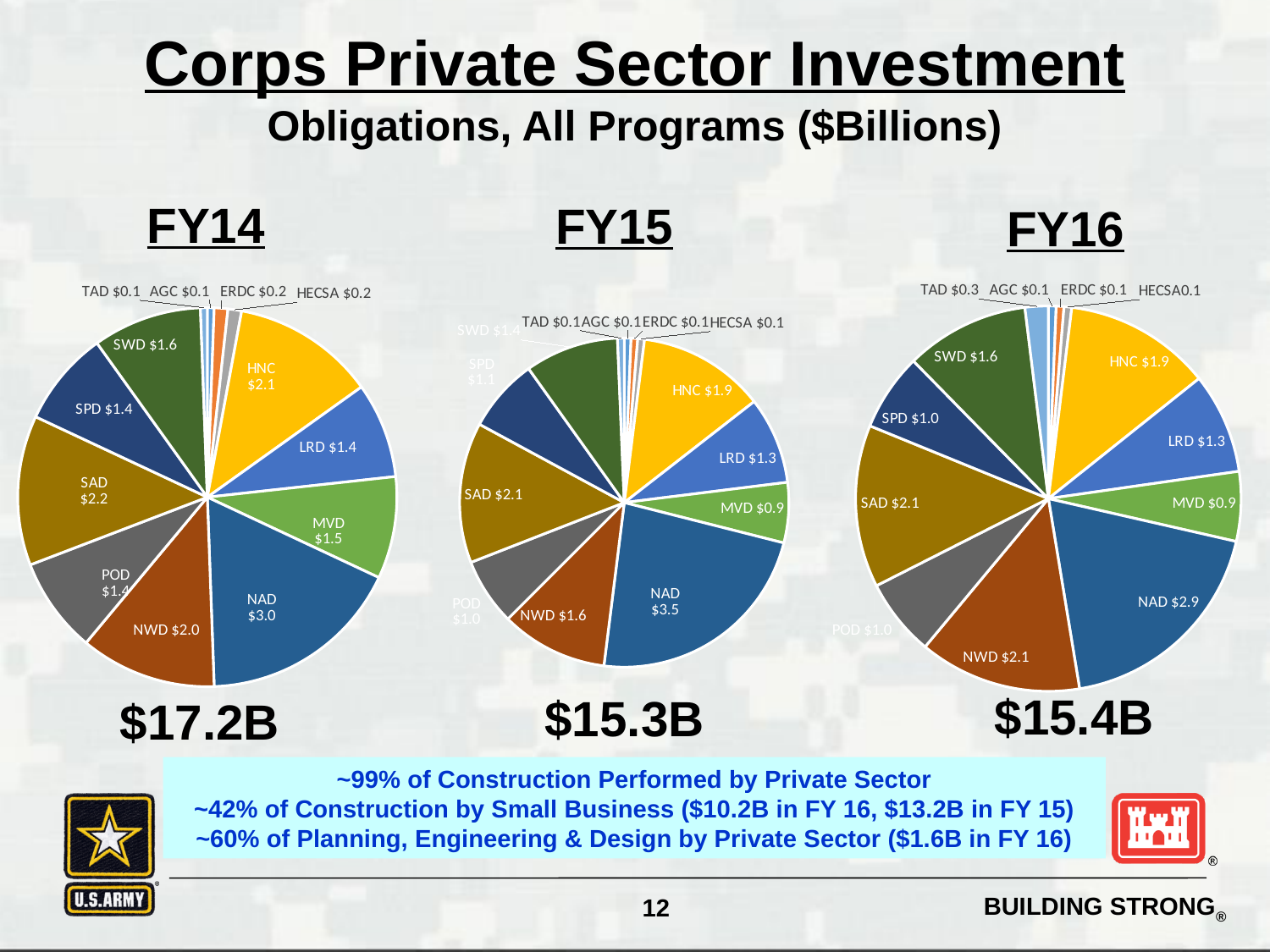
What type of chart is used for FY14, FY15 and FY16? Pie chart In the FY15 pie chart, what is the value for HNC? $1.9 In the FY14 pie chart, which category has the largest slice? NAD In the FY14 pie chart, what is the difference between the NAD value and the HNC value? $0.9 What is the difference between the NAD value in the FY15 pie chart and the NAD value in the FY16 pie chart? $0.6 In the FY16 pie chart, which is larger, SAD or LRD? SAD What total is shown beneath the FY16 pie chart? $15.4B How many slices does the FY15 pie chart have? 13 In the FY15 pie chart, which category has the largest slice? NAD In the FY14 pie chart, what is the value for NAD? $3.0 In the FY16 pie chart, what is the value for NWD? $2.1 In the FY16 pie chart, what is the value for TAD? $0.3